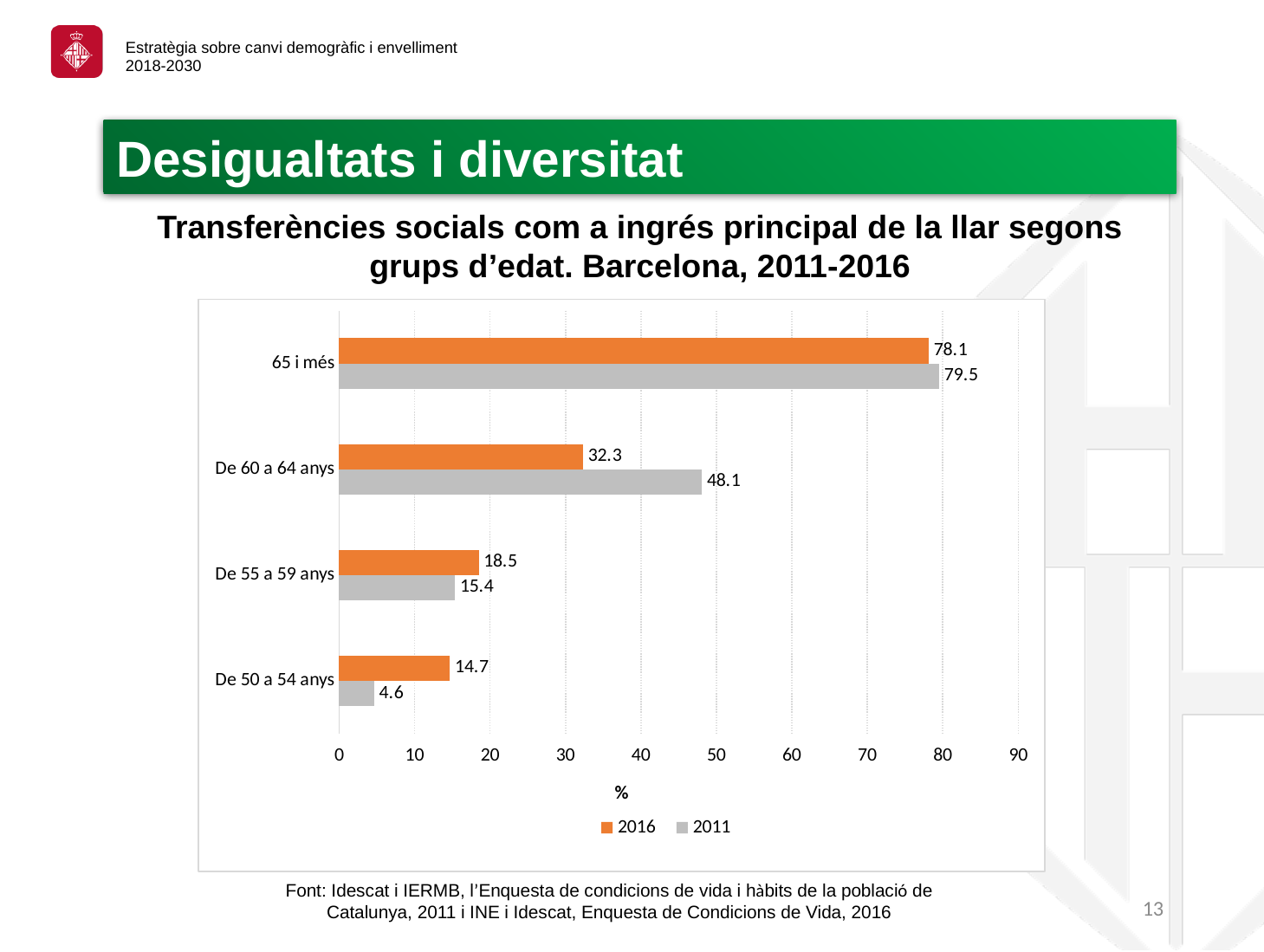
What is the value for 'De 60 a 64 anys' in 2011? 48.1 Which age group has the highest value in 2016? 65 i més What is the value for '65 i més' in 2016? 78.1 What kind of chart is shown on the slide? Bar chart What is the difference between the 2011 and 2016 values for 'De 60 a 64 anys'? 15.8 Which age group has the lowest value in 2011? De 50 a 54 anys Which colour represents the 2016 series in the chart? Orange How many age groups are shown in the chart? 4 What is the value for 'De 50 a 54 anys' in 2011? 4.6 Which is larger for 'De 55 a 59 anys': the 2016 value or the 2011 value? 2016 What is the value for 'De 55 a 59 anys' in 2016? 18.5 How many series does the legend list? 2